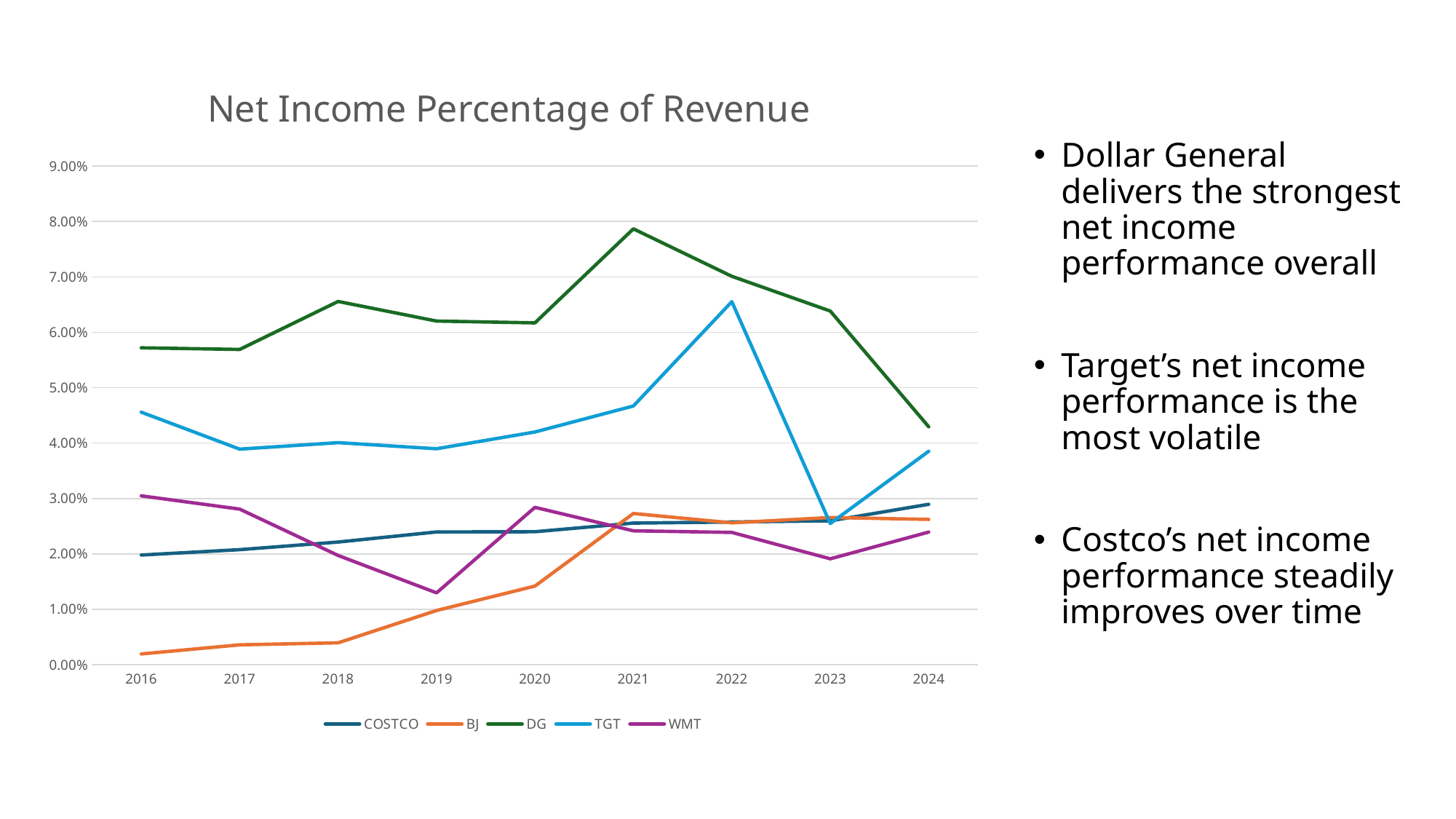
Which series has the highest value in 2021? DG In 2019, which is higher: COSTCO or WMT? COSTCO In which year does the DG series reach its peak? 2021 What is the title of the chart? Net Income Percentage of Revenue In which year is the TGT series at its lowest? 2023 Is the value for BJ in 2016 greater or less than 1.00%? less Does the COSTCO series generally rise or fall from 2016 to 2024? rise How many series does the legend list? 5 Which series has the lowest value in 2018? BJ How many years are plotted along the x axis? 9 What kind of chart is shown on the slide? line chart Is the value for DG in 2021 greater or less than 7.00%? greater